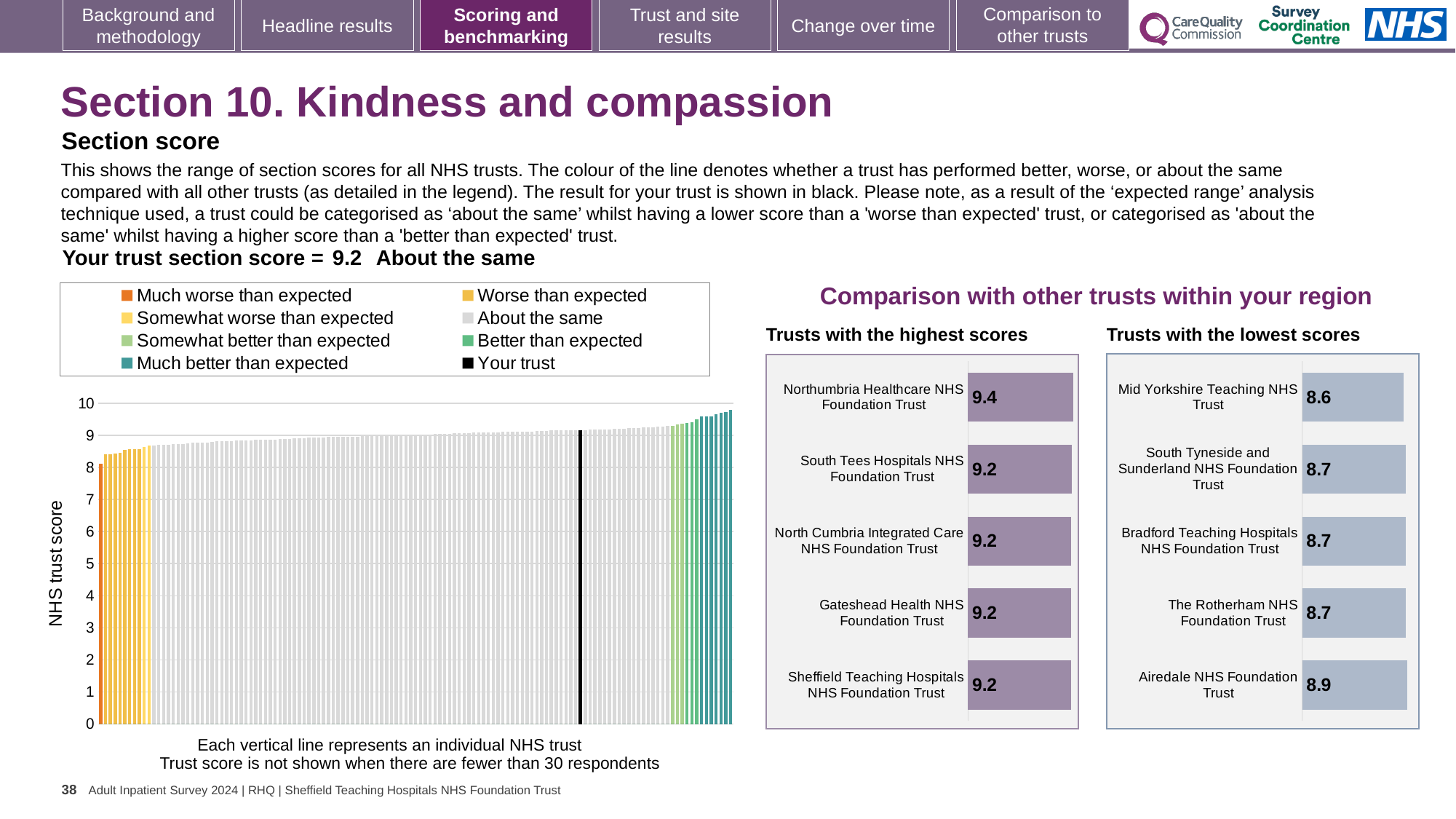
In the 'Trusts with the highest scores' chart, what is the score for Northumbria Healthcare NHS Foundation Trust? 9.4 In the 'Trusts with the highest scores' chart, which trust has the highest score? Northumbria Healthcare NHS Foundation Trust In the 'NHS trust score' chart on the left, is the value for the black 'Your trust' bar greater or less than 8? greater What kind of chart is the 'NHS trust score' chart on the left of the slide? bar chart In the 'NHS trust score' chart on the left, do the bar values rise or fall from left to right along the x axis? rise In the 'Trusts with the lowest scores' chart, which has the larger score: Airedale NHS Foundation Trust or Mid Yorkshire Teaching NHS Trust? Airedale NHS Foundation Trust In the 'Trusts with the highest scores' chart, how many trusts are shown? 5 In the 'Trusts with the highest scores' chart, what is the difference between the scores of Northumbria Healthcare NHS Foundation Trust and South Tees Hospitals NHS Foundation Trust? 0.2 In the 'Trusts with the lowest scores' chart, which trust has the lowest score? Mid Yorkshire Teaching NHS Trust In the 'NHS trust score' chart on the left, how many entries does the legend list? 8 In the 'NHS trust score' chart on the left, what colour represents 'Your trust' in the legend? black In the 'Trusts with the lowest scores' chart, what is the score for Mid Yorkshire Teaching NHS Trust? 8.6